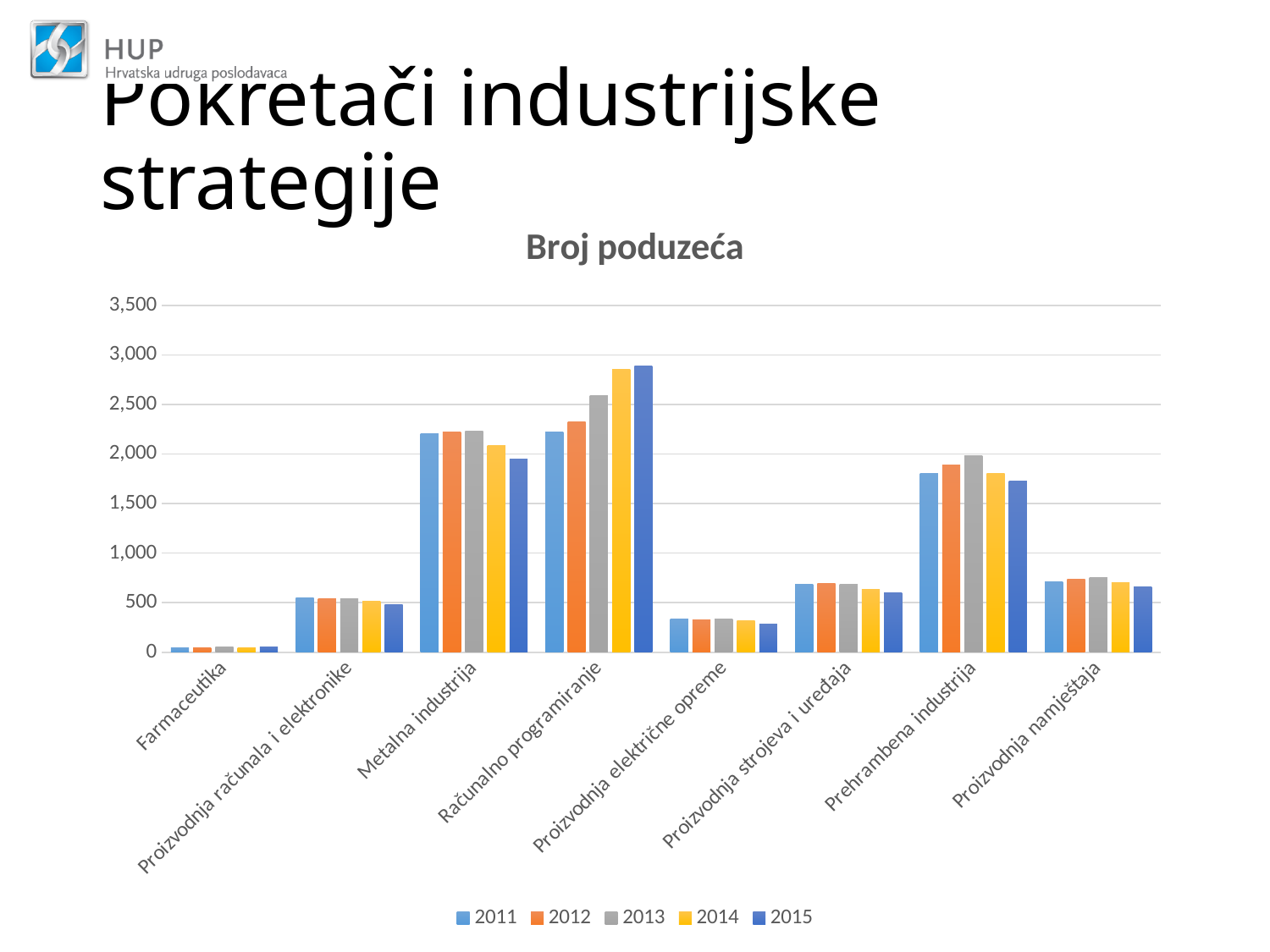
What kind of chart is shown on the slide? bar chart How many industry categories are shown on the x axis of the chart? 8 Which category has the lowest number of companies in 2011? Farmaceutika Which category has the highest number of companies in 2015? Računalno programiranje Is the 2015 value for Prehrambena industrija greater or less than 2,000? less Do the values for Računalno programiranje rise or fall from 2011 to 2015? rise Is the 2014 value for Računalno programiranje greater or less than 2,500? greater Is the 2011 value for Proizvodnja električne opreme greater or less than 500? less What is the title of the chart? Broj poduzeća In 2015, which has more companies: Metalna industrija or Računalno programiranje? Računalno programiranje How many series does the legend list? 5